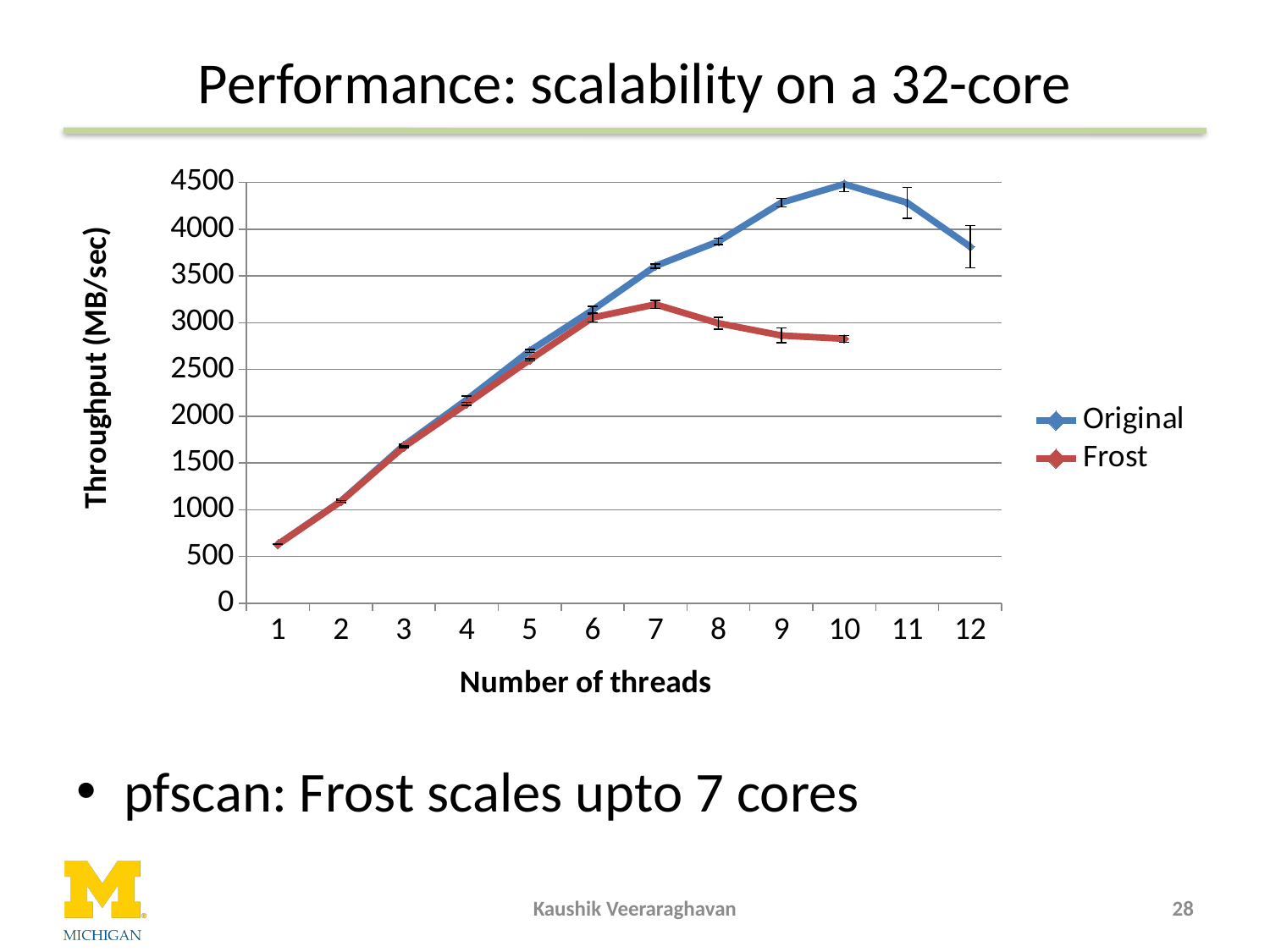
What are the names of the two series in the legend? Original and Frost At which number of threads does the Frost series reach its highest throughput? 7 Does the Frost throughput rise or fall as the number of threads increases from 7 to 10? fall How many thread counts are shown on the x axis? 12 What kind of chart is shown on the slide? line chart At 9 threads, which series has the higher throughput, Original or Frost? Original At which number of threads is the Frost throughput lowest? 1 Is the Frost throughput at 9 threads greater or less than 3000 MB/sec? less At which number of threads does the Original series reach its highest throughput? 10 Is the Original throughput at 12 threads greater or less than 4000 MB/sec? less How many series does the legend list? 2 Is the Original throughput at 10 threads greater or less than 4000 MB/sec? greater